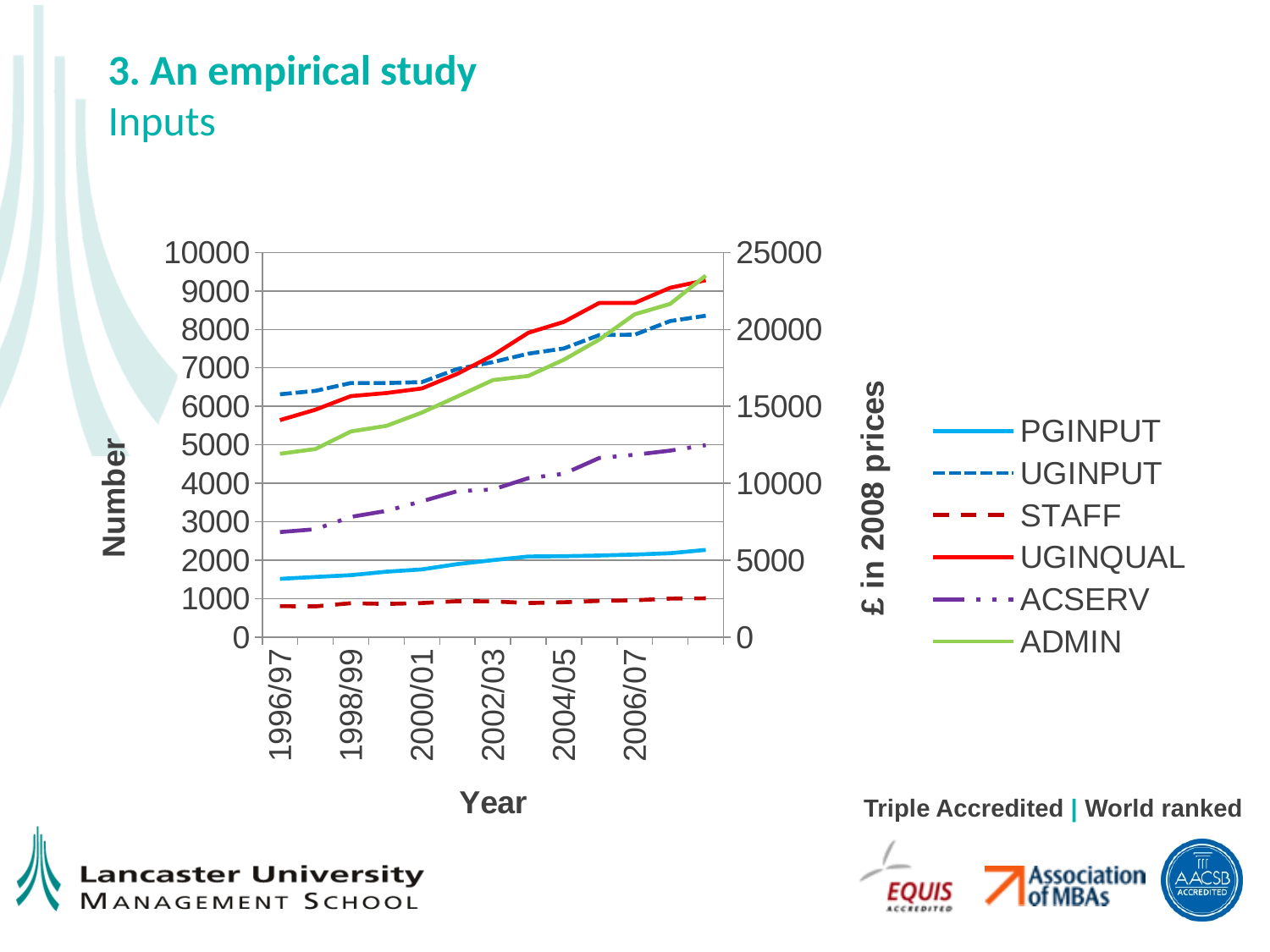
What is the title of the chart's x axis? Year Which series is plotted lowest on the chart across all years? STAFF What is the title of the right-hand vertical axis? £ in 2008 prices Reading against the left axis, is the UGINPUT value for 1996/97 greater or less than 6000? greater Does the ADMIN line rise or fall across the years shown? rise Reading against the left axis, is the STAFF value for 1996/97 greater or less than 1000? less Does the UGINQUAL line rise or fall from 1996/97 to the end of the series? rise How many year labels are printed on the x axis? 6 How many series does the chart's legend list? 6 What kind of chart is shown on the slide? line chart Reading against the left axis, is the PGINPUT value for 1996/97 greater or less than 2000? less